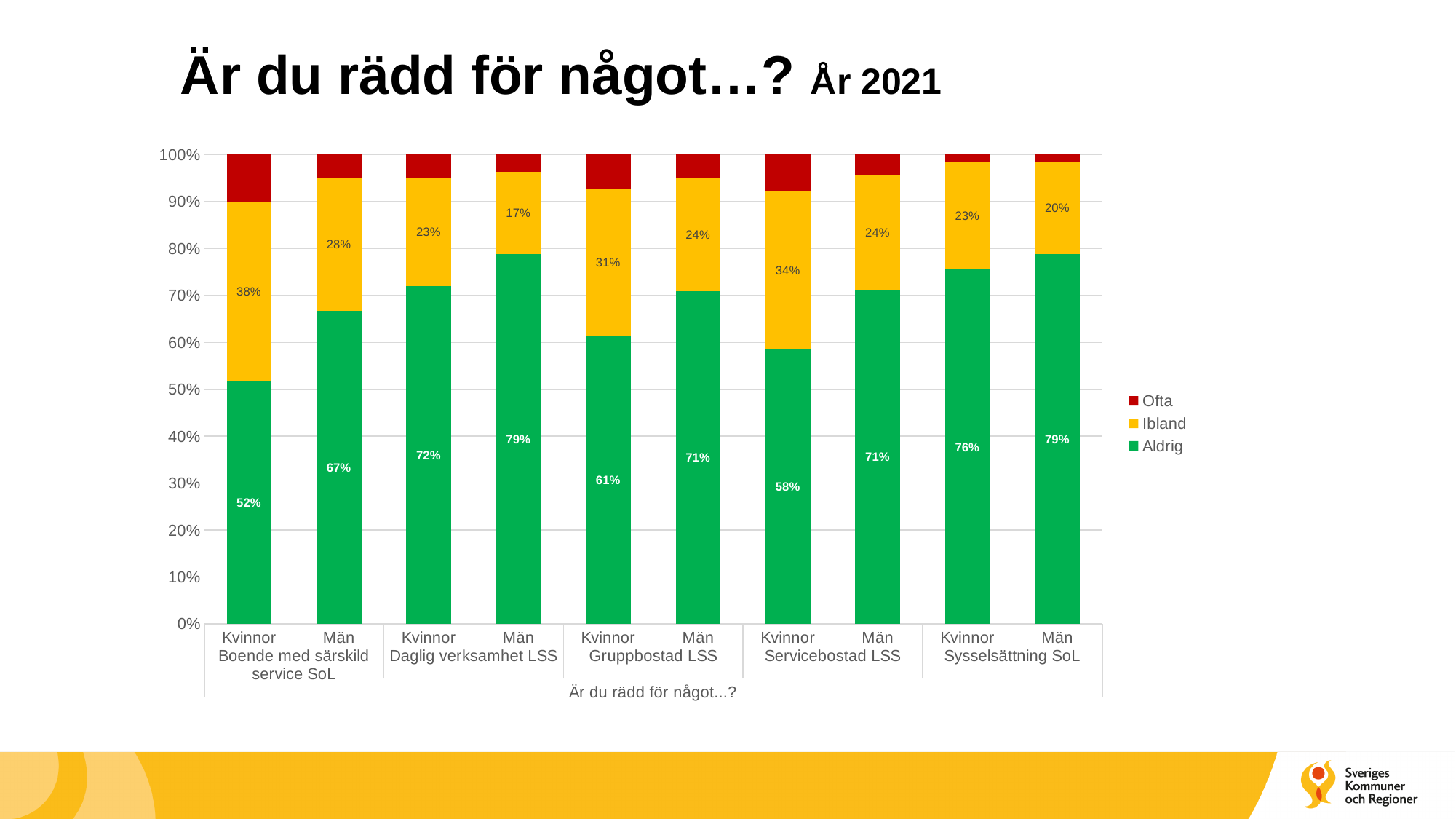
What is the Ibland value for Kvinnor in Gruppbostad LSS? 31% Which series is shown in red in the legend? Ofta What percentage of Kvinnor in Boende med särskild service SoL answered Aldrig? 52% How many series does the legend list? 3 What kind of chart is shown on the slide? Stacked bar chart What is the difference in the Aldrig value between Män and Kvinnor in Boende med särskild service SoL? 15 percentage points What is the Ibland value for Män in Daglig verksamhet LSS? 17% Which group has the lowest Aldrig value? Kvinnor, Boende med särskild service SoL Which has a larger Aldrig value: Kvinnor in Gruppbostad LSS or Kvinnor in Sysselsättning SoL? Kvinnor in Sysselsättning SoL Which group has the highest Ibland value? Kvinnor, Boende med särskild service SoL How many bars are shown in the chart? 10 What is the Aldrig value for Kvinnor in Servicebostad LSS? 58%